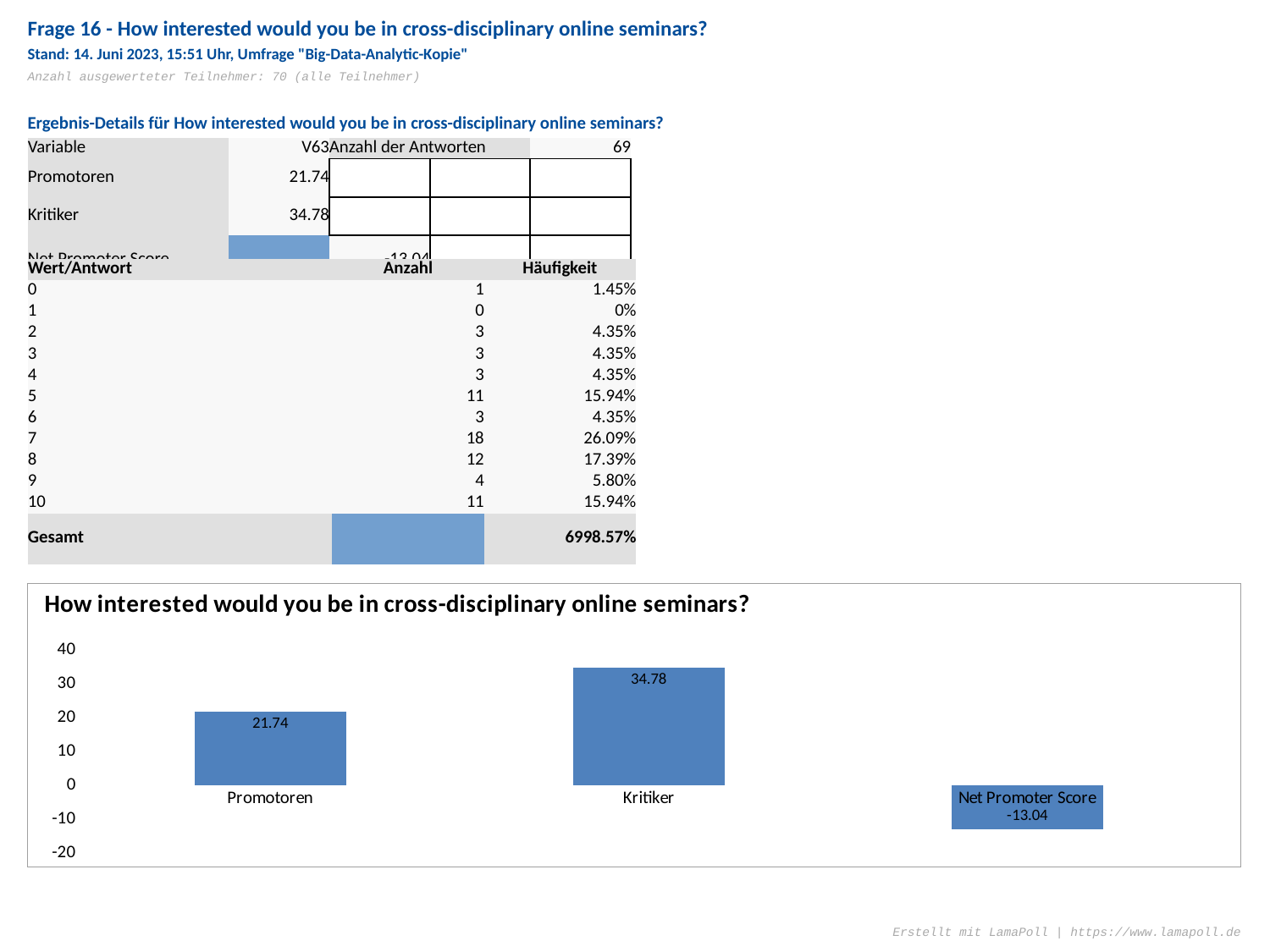
What kind of chart is shown on the slide? bar chart Is the value for Promotoren greater or less than 20? greater Is the value for Kritiker greater or less than 30? greater Which is larger, the value for Promotoren or the value for Kritiker? Kritiker What is the value for Net Promoter Score in the chart? -13.04 How many categories are shown in the chart? 3 What is the value for Promotoren in the chart? 21.74 What is the value for Kritiker in the chart? 34.78 What is the title of the chart? How interested would you be in cross-disciplinary online seminars? Which category has the highest value in the chart? Kritiker Which category has the lowest value in the chart? Net Promoter Score What is the difference between the values for Kritiker and Promotoren? 13.04